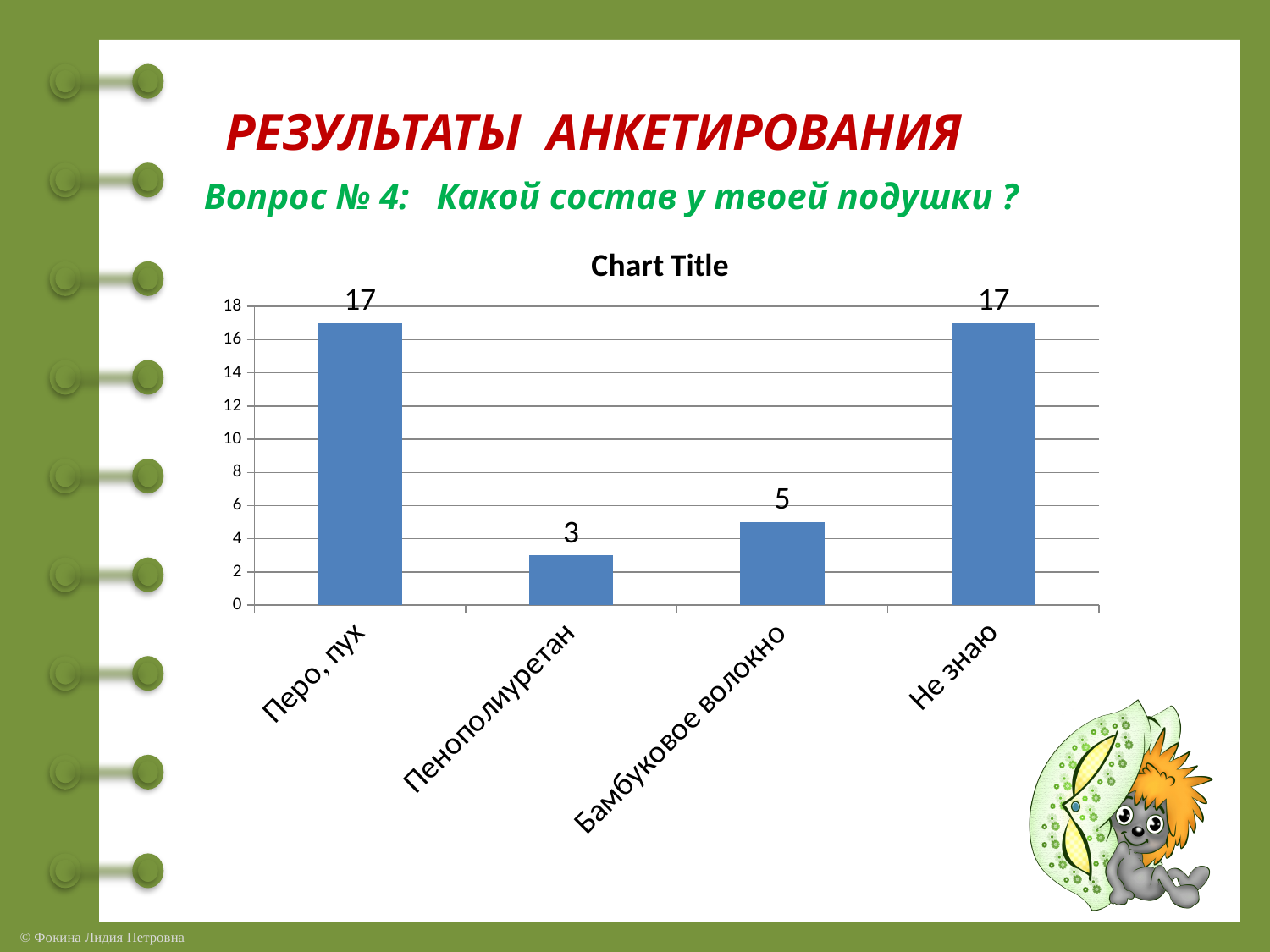
What is the value for Бамбуковое волокно? 5 What kind of chart is shown on the slide? bar chart What is the value for Не знаю? 17 What is the value for Перо, пух? 17 How many categories are shown on the x axis? 4 What is the value for Пенополиуретан? 3 Is the value for Не знаю greater or less than 10? greater Which category has the lowest value? Пенополиуретан Which is larger, the value for Бамбуковое волокно or the value for Пенополиуретан? Бамбуковое волокно What is the title shown above the chart? Chart Title What is the difference between the values for Бамбуковое волокно and Пенополиуретан? 2 What is the difference between the values for Перо, пух and Бамбуковое волокно? 12